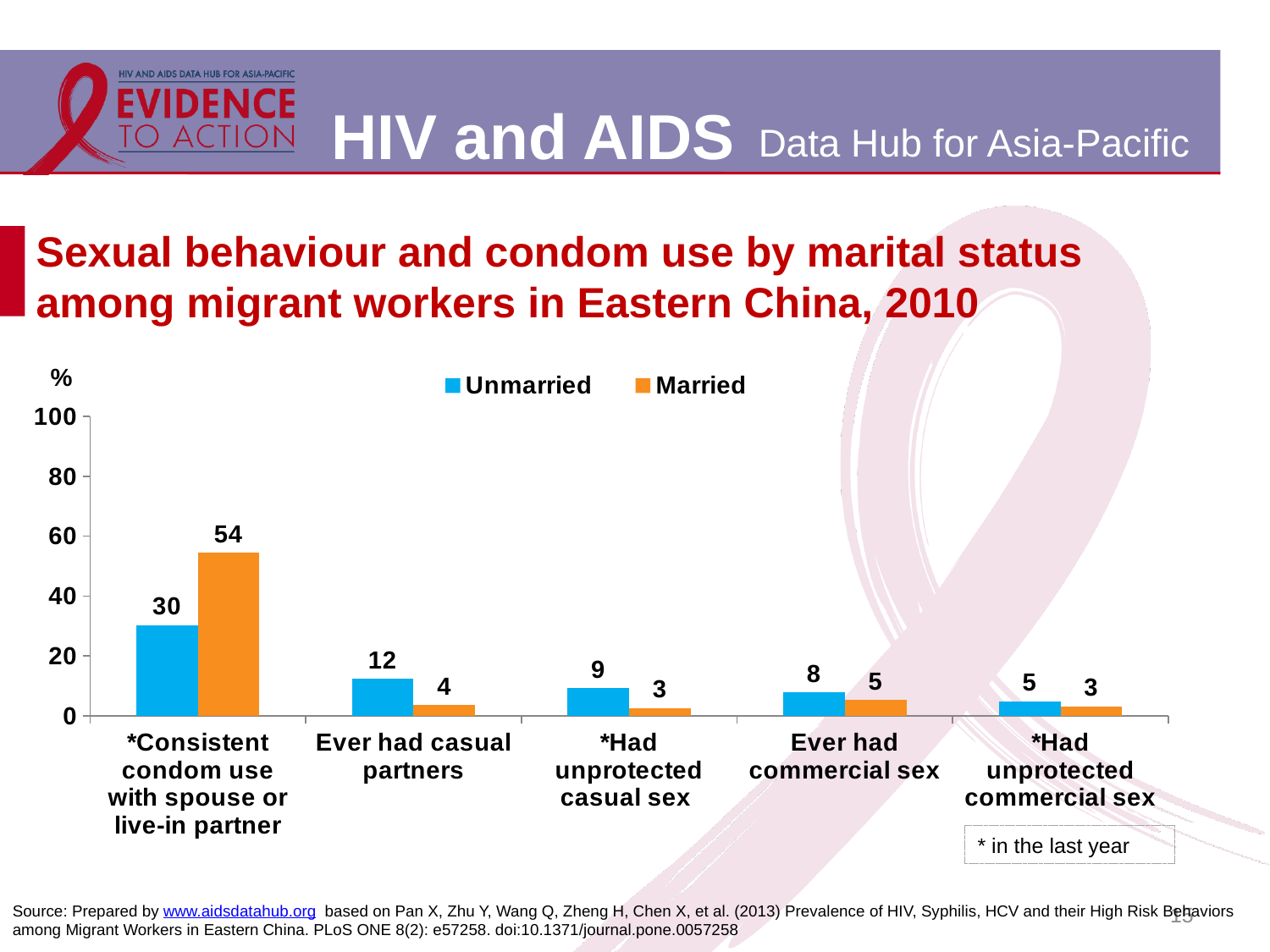
Which category has the highest Married value? *Consistent condom use with spouse or live-in partner What is the Married value for '*Consistent condom use with spouse or live-in partner'? 54 How many categories are shown on the x axis? 5 How many series does the legend list? 2 What is the Unmarried value for '*Consistent condom use with spouse or live-in partner'? 30 Which category has the lowest Unmarried value? *Had unprotected commercial sex For 'Ever had casual partners', which is larger, the Unmarried or the Married value? Unmarried What kind of chart is shown on the slide? Bar chart What is the Unmarried value for 'Ever had casual partners'? 12 Is the Married value for '*Consistent condom use with spouse or live-in partner' greater or less than 40? greater What is the Married value for '*Had unprotected casual sex'? 3 What is the difference between the Married and Unmarried values for '*Consistent condom use with spouse or live-in partner'? 24